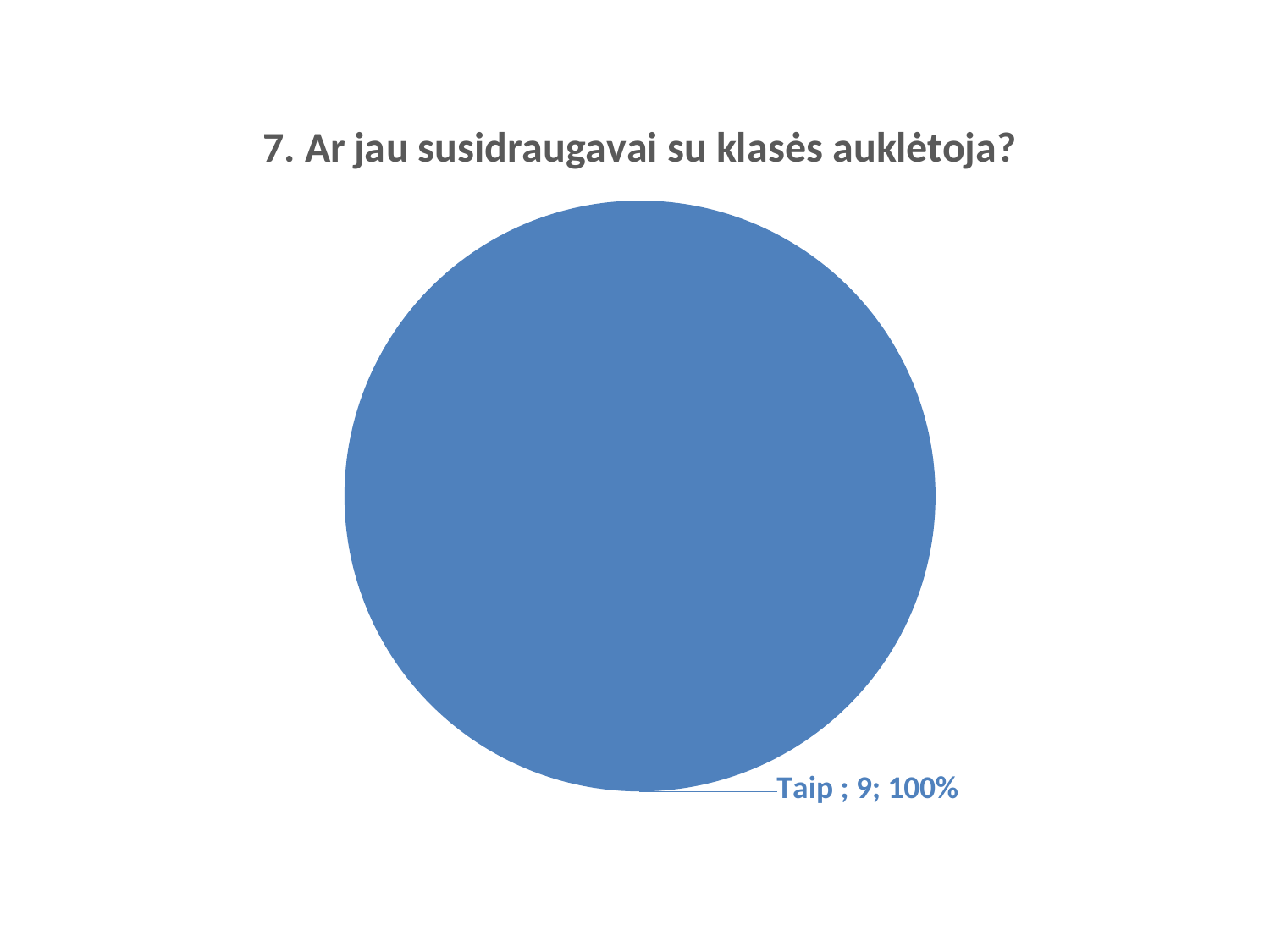
What kind of chart is shown on the slide? pie chart What is the title of the chart? 7. Ar jau susidraugavai su klasės auklėtoja? Which category has the largest share of the pie? Taip What is the value shown for the "Taip" slice? 9 What is the total of all values shown in the pie chart? 9 What share of the pie does the "Taip" slice represent? 100% How many slices does the pie chart have? 1 What is the label of the only slice in the pie chart? Taip